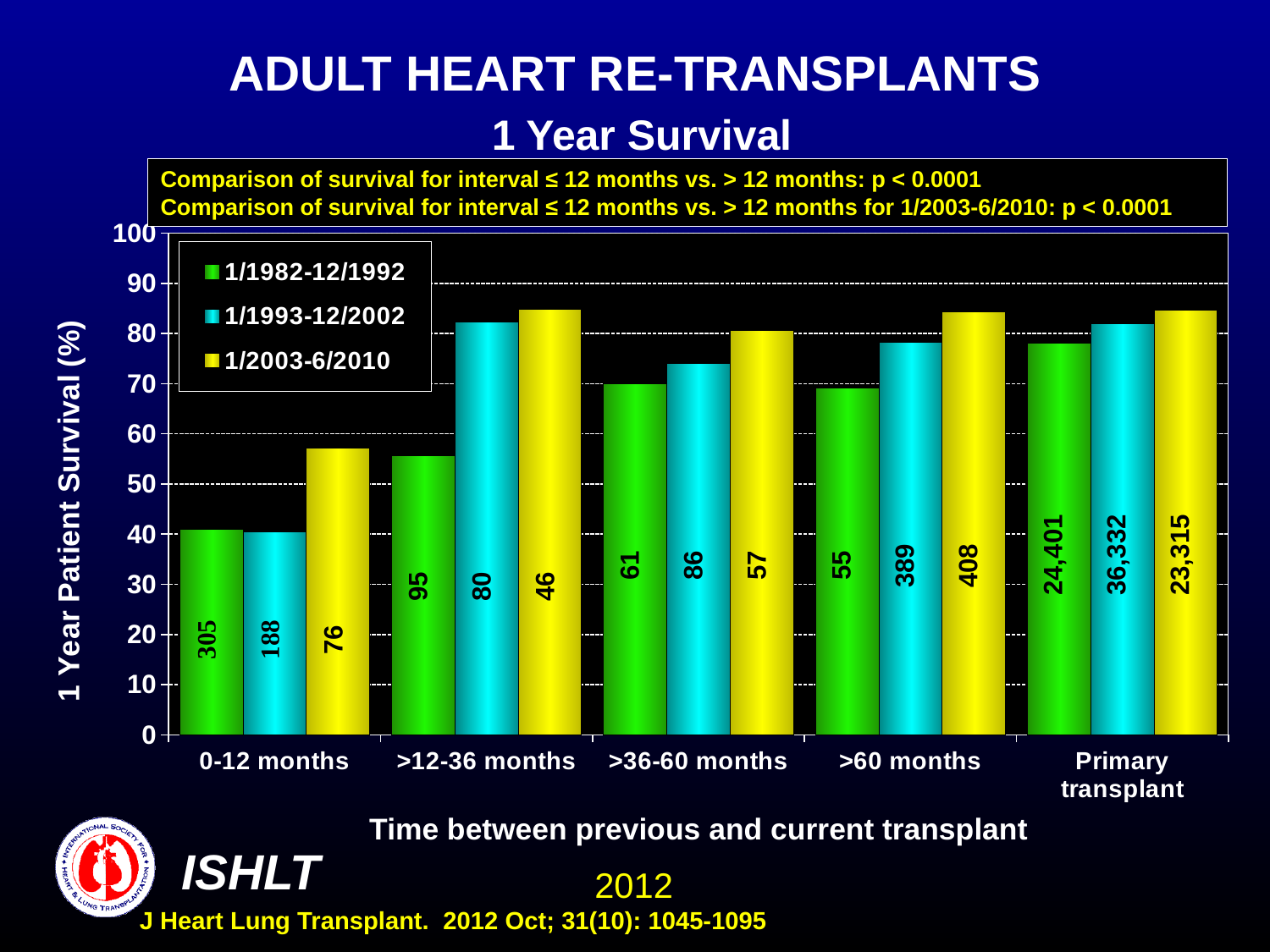
For the 1/2003-6/2010 series, which category has the lowest 1 year survival? 0-12 months What number is printed on the 1/2003-6/2010 bar for Primary transplant? 23,315 Is the 1 year survival for 0-12 months in the 1/1982-12/1992 series greater or less than 50%? less How many categories are shown on the x axis? 5 For the >12-36 months category, which series has the higher 1 year survival: 1/1982-12/1992 or 1/1993-12/2002? 1/1993-12/2002 What is the x-axis title of the chart? Time between previous and current transplant Is the 1 year survival for >12-36 months in the 1/1993-12/2002 series greater or less than 70%? greater What are the three series listed in the legend? 1/1982-12/1992, 1/1993-12/2002, 1/2003-6/2010 Is the 1 year survival for 0-12 months in the 1/2003-6/2010 series greater or less than 50%? greater What number is printed on the 1/1982-12/1992 bar for 0-12 months? 305 What kind of chart is shown on the slide? bar chart How many series does the legend list? 3